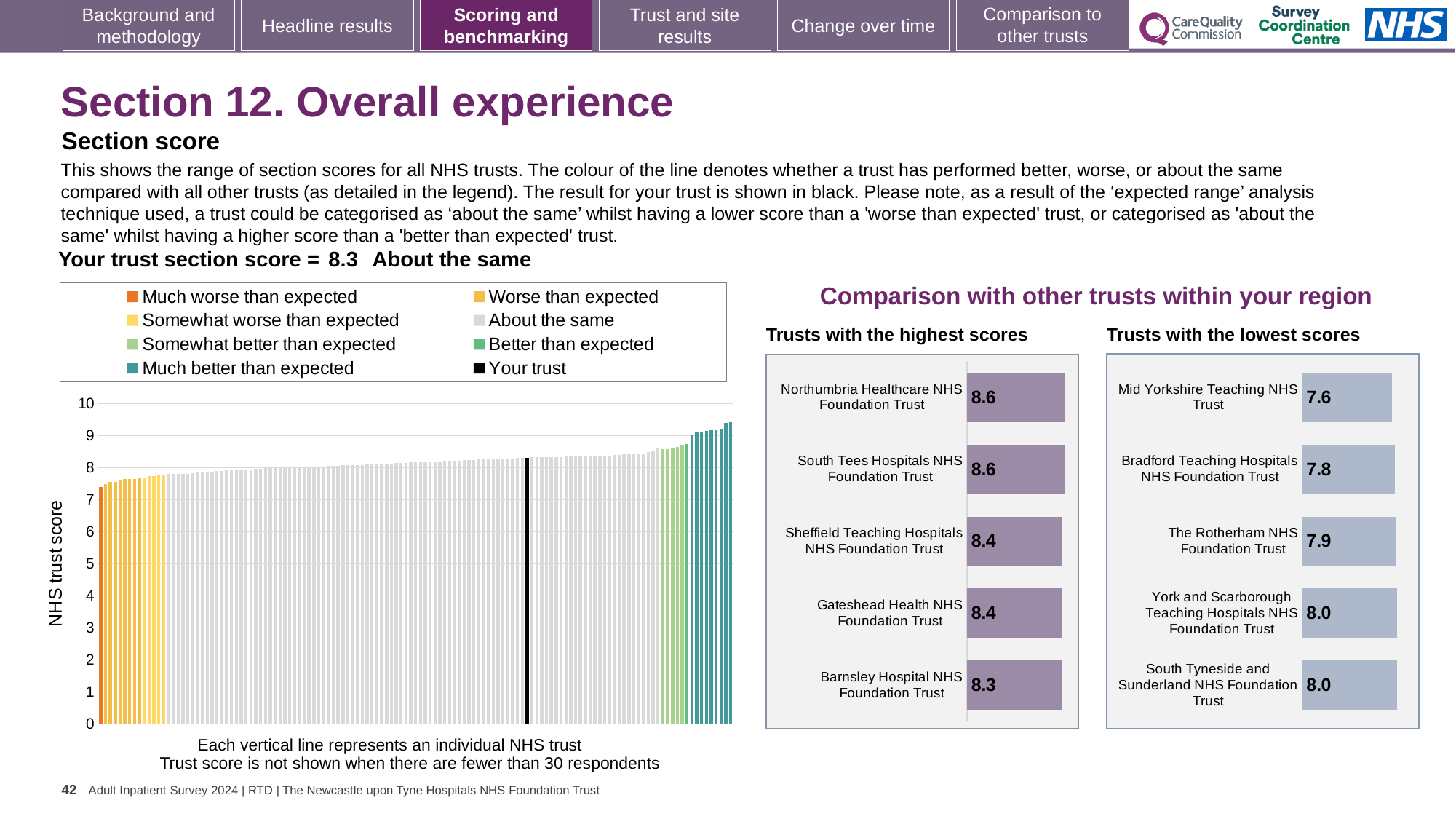
In the 'Trusts with the lowest scores' chart, what is the score for South Tyneside and Sunderland NHS Foundation Trust? 8.0 In the 'Trusts with the lowest scores' chart, what is the score for Mid Yorkshire Teaching NHS Trust? 7.6 In the large chart on the left showing all NHS trusts, what is the section score for your trust? 8.3 In the 'Trusts with the highest scores' chart, what is the score for Northumbria Healthcare NHS Foundation Trust? 8.6 In the 'Trusts with the lowest scores' chart, which trust has the lowest score? Mid Yorkshire Teaching NHS Trust In the 'Trusts with the lowest scores' chart, which has the larger score: Bradford Teaching Hospitals NHS Foundation Trust or The Rotherham NHS Foundation Trust? The Rotherham NHS Foundation Trust In the 'Trusts with the highest scores' chart, what is the difference between the scores of Northumbria Healthcare NHS Foundation Trust and Barnsley Hospital NHS Foundation Trust? 0.3 In the 'Trusts with the lowest scores' chart, what is the difference between the scores of Bradford Teaching Hospitals NHS Foundation Trust and Mid Yorkshire Teaching NHS Trust? 0.2 What kind of chart is the large chart on the left showing all NHS trusts? Bar chart In the 'Trusts with the highest scores' chart, what is the score for Sheffield Teaching Hospitals NHS Foundation Trust? 8.4 In the 'Trusts with the highest scores' chart, which trust has the lowest score? Barnsley Hospital NHS Foundation Trust How many trusts are shown in the 'Trusts with the highest scores' chart? 5